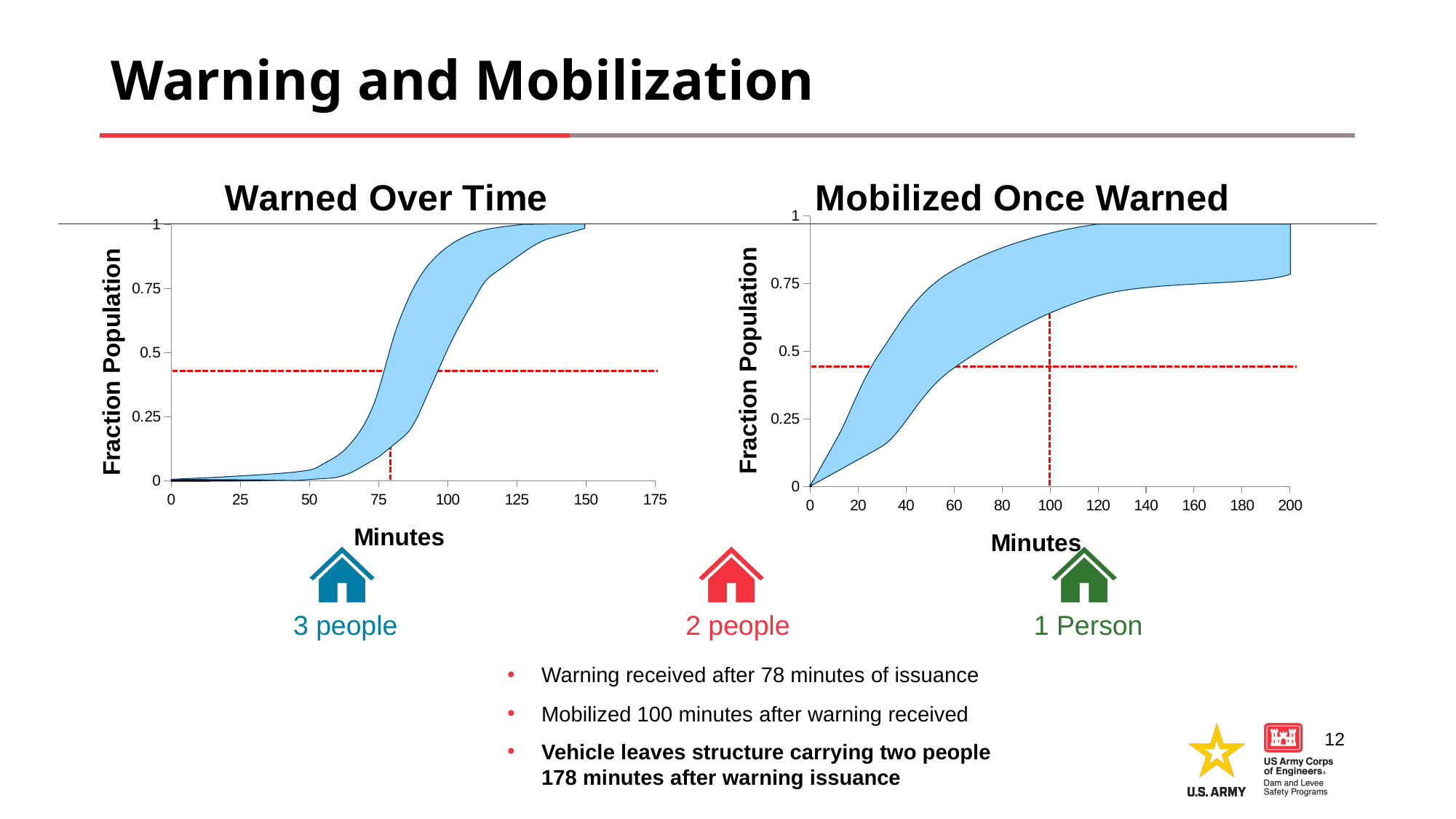
What is the y-axis label of the "Mobilized Once Warned" chart? Fraction Population In the "Warned Over Time" chart, is the fraction of population at 150 minutes greater or less than 0.75? greater In the "Mobilized Once Warned" chart, is the fraction of population at 200 minutes greater or less than 0.5? greater In the "Mobilized Once Warned" chart, does the fraction of population rise or fall as minutes increase? rise What is the title of the chart on the left side of the slide? Warned Over Time What kind of chart is the "Warned Over Time" chart? area chart In the "Warned Over Time" chart, is the fraction of population at 50 minutes greater or less than 0.25? less In the "Warned Over Time" chart, does the fraction of population rise or fall as minutes increase? rise